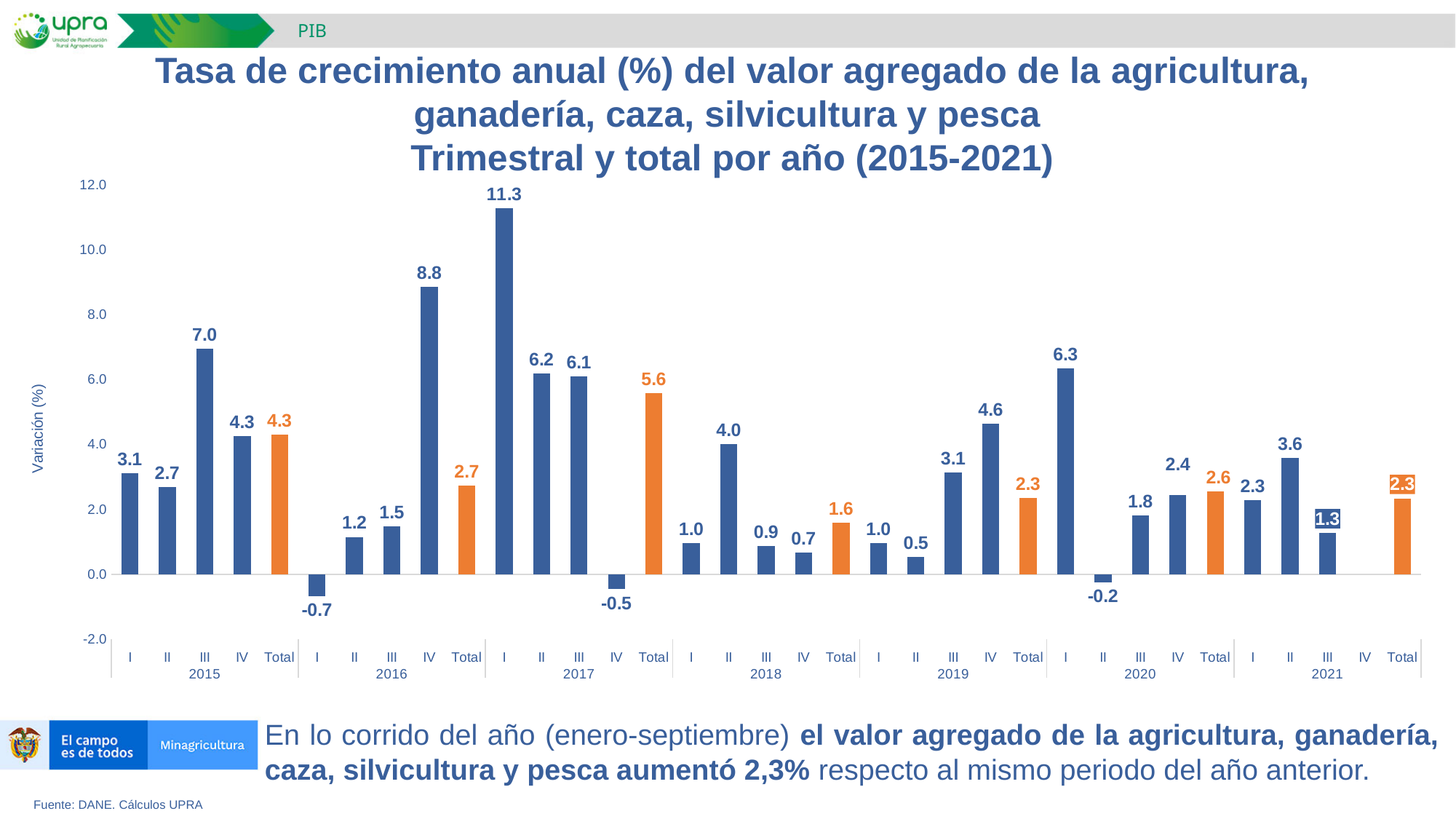
What is the annual total growth rate for 2017? 5.6 Which bar has the lowest value in the chart? I 2016 What is the label of the vertical axis? Variación (%) What type of chart is shown on the slide? bar chart Do the quarterly values in 2017 rise or fall from quarter I to quarter IV? fall Which is larger, the value for quarter III of 2015 or quarter I of 2020? III 2015 Is the value for quarter IV of 2019 greater or less than 4.0? greater What is the difference between the annual totals for 2017 and 2018? 4.0 What is the value for quarter IV of 2016? 8.8 How many annual total bars (orange) are shown in the chart? 7 What is the value for quarter I of 2017? 11.3 Which bar has the highest value in the chart? I 2017